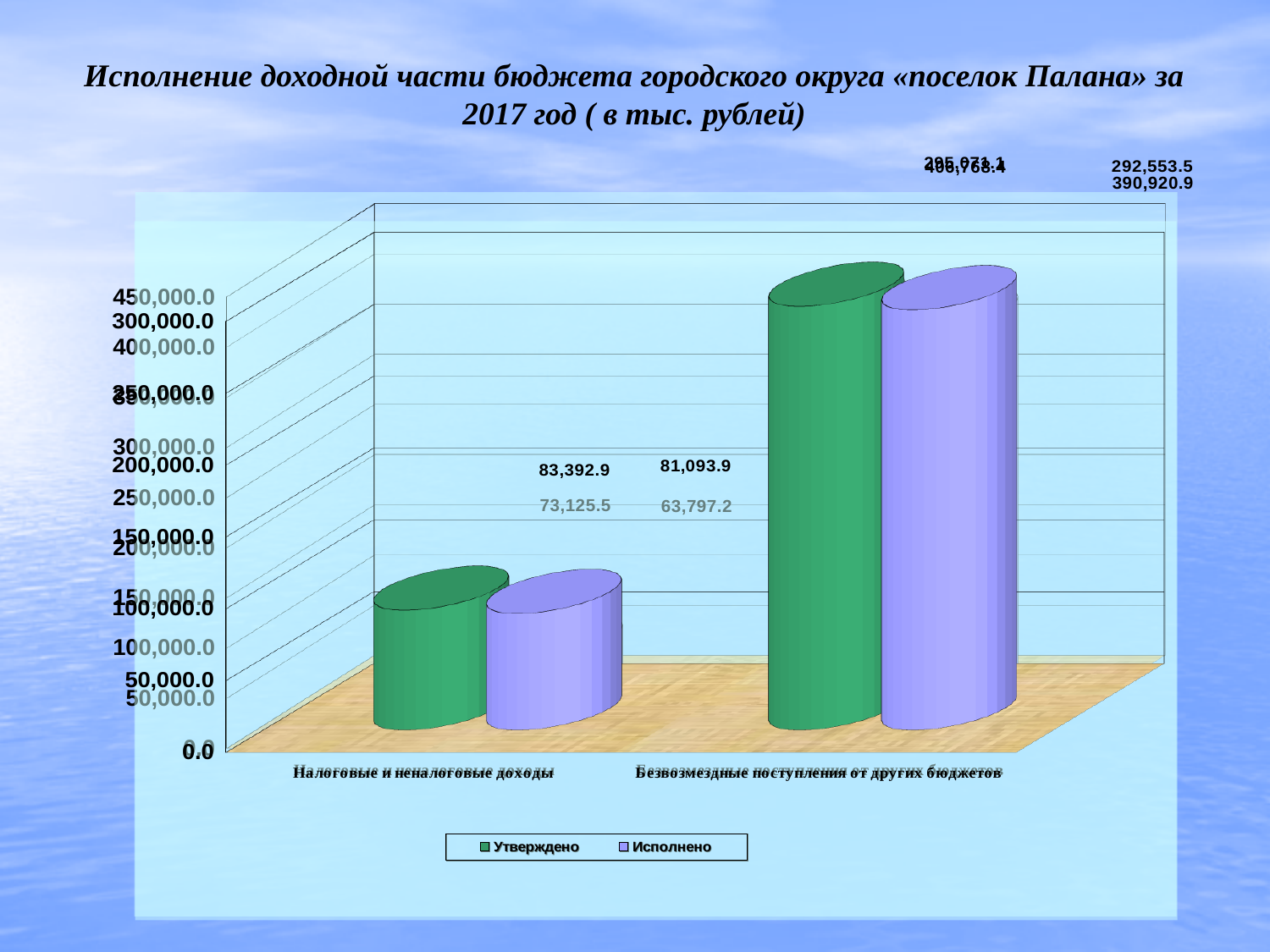
How many categories are shown on the x axis of the chart? 2 What are the two series named in the legend? Утверждено and Исполнено What kind of chart is shown on the slide? bar chart Which category has the highest bars in the chart? Безвозмездные поступления от других бюджетов For Безвозмездные поступления от других бюджетов, which is larger: Утверждено or Исполнено? Утверждено For Налоговые и неналоговые доходы, which is larger: Утверждено or Исполнено? Утверждено How many series does the chart's legend list? 2 Which colour represents the series Исполнено in the legend? purple Is the value of Исполнено for Безвозмездные поступления от других бюджетов greater or less than 200,000.0? greater Is the value of Утверждено for Безвозмездные поступления от других бюджетов greater or less than 200,000.0? greater Which category has the lowest bars in the chart? Налоговые и неналоговые доходы